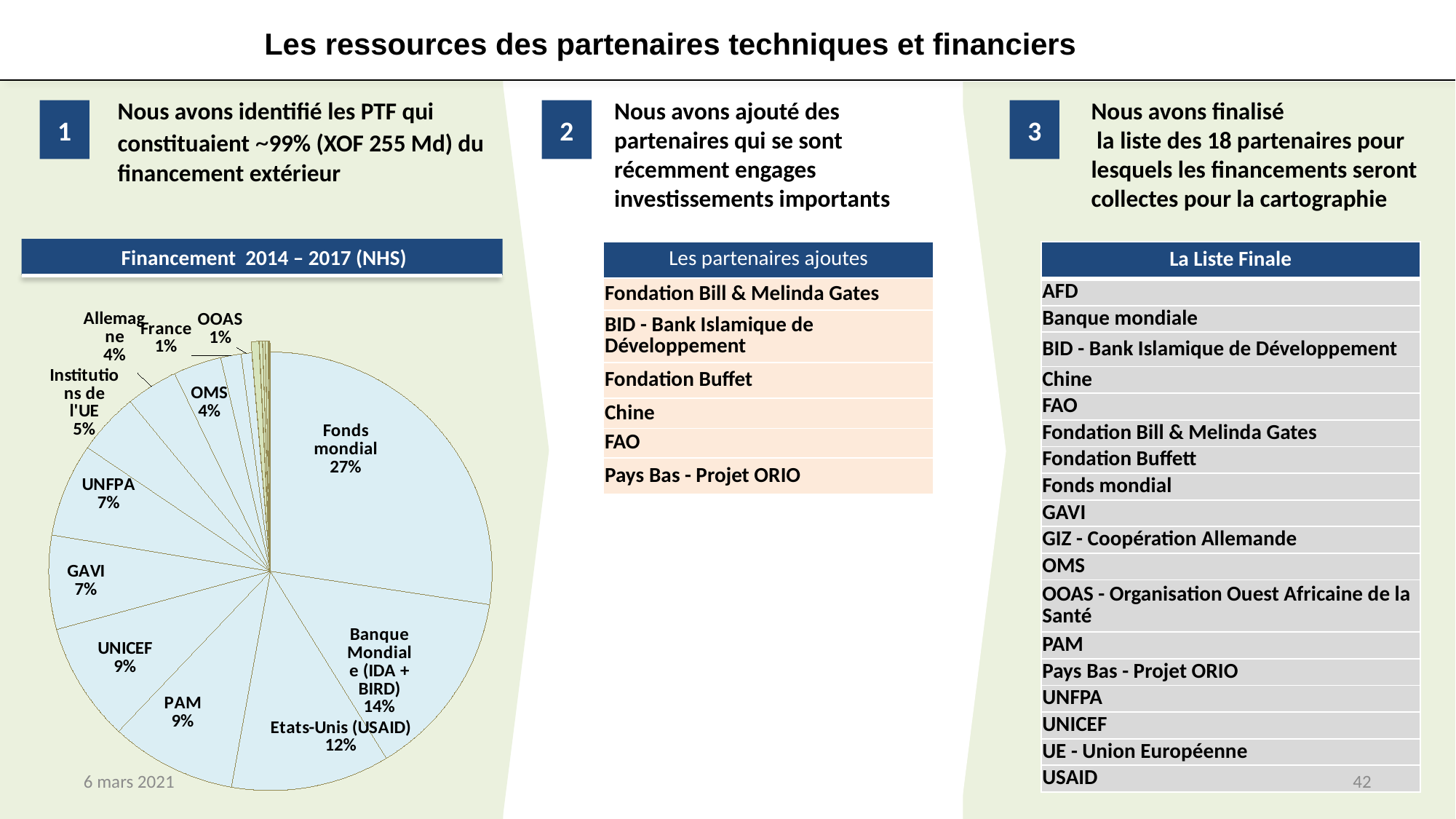
What share does UNICEF have in the pie chart? 9% Which is larger in the pie chart, Institutions de l'UE or OMS? Institutions de l'UE Which is larger in the pie chart, PAM or GAVI? PAM What percentage is shown for Etats-Unis (USAID) in the pie chart? 12% What kind of chart is shown under the heading 'Financement 2014 – 2017 (NHS)'? pie chart What share of the pie does Fonds mondial hold? 27% Which category has the largest slice of the pie? Fonds mondial What is the combined share of UNFPA and GAVI in the pie chart? 14% What percentage is shown for Banque Mondiale (IDA + BIRD)? 14% What is the title shown above the pie chart? Financement 2014 – 2017 (NHS) What is the difference in percentage points between Fonds mondial and Banque Mondiale (IDA + BIRD)? 13